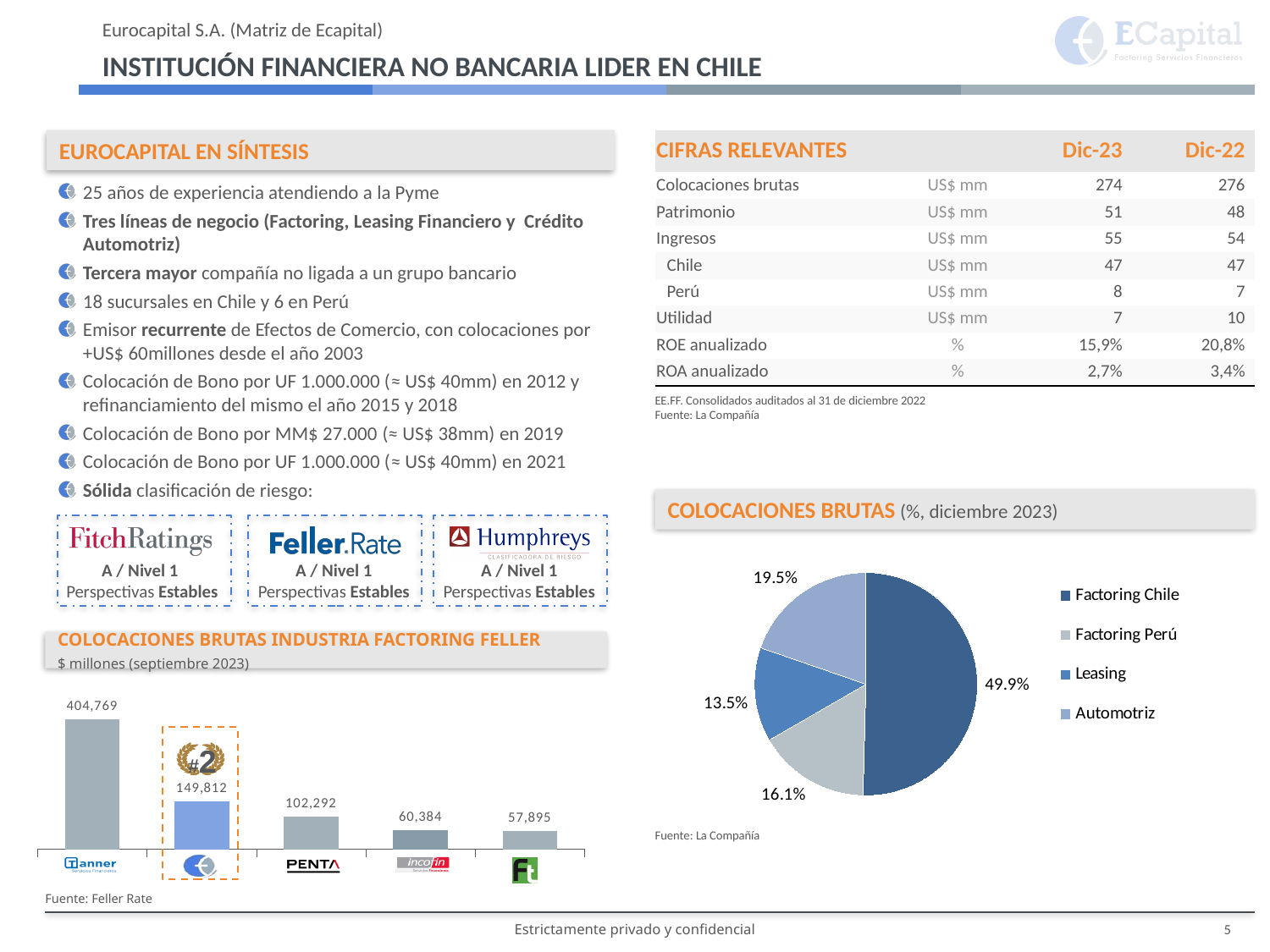
In the pie chart 'COLOCACIONES BRUTAS (%, diciembre 2023)', what share does Automotriz have? 19.5% In the pie chart 'COLOCACIONES BRUTAS (%, diciembre 2023)', which segment is the smallest? Leasing In the pie chart 'COLOCACIONES BRUTAS (%, diciembre 2023)', what share does Leasing have? 13.5% In the bar chart 'COLOCACIONES BRUTAS INDUSTRIA FACTORING FELLER', what is the value of the highest bar? 404,769 In the bar chart 'COLOCACIONES BRUTAS INDUSTRIA FACTORING FELLER', what is the difference between the Tanner bar (404,769) and the second bar (149,812)? 254,957 In the pie chart 'COLOCACIONES BRUTAS (%, diciembre 2023)', what share does Factoring Chile have? 49.9% In the pie chart 'COLOCACIONES BRUTAS (%, diciembre 2023)', which segment is the largest? Factoring Chile What type of chart is 'COLOCACIONES BRUTAS INDUSTRIA FACTORING FELLER'? Bar chart In the bar chart 'COLOCACIONES BRUTAS INDUSTRIA FACTORING FELLER', what is the value for Penta? 102,292 How many bars are shown in the bar chart 'COLOCACIONES BRUTAS INDUSTRIA FACTORING FELLER'? 5 In the pie chart 'COLOCACIONES BRUTAS (%, diciembre 2023)', what is the difference in percentage points between Factoring Perú and Leasing? 2.6 How many segments does the legend of the pie chart 'COLOCACIONES BRUTAS (%, diciembre 2023)' list? 4